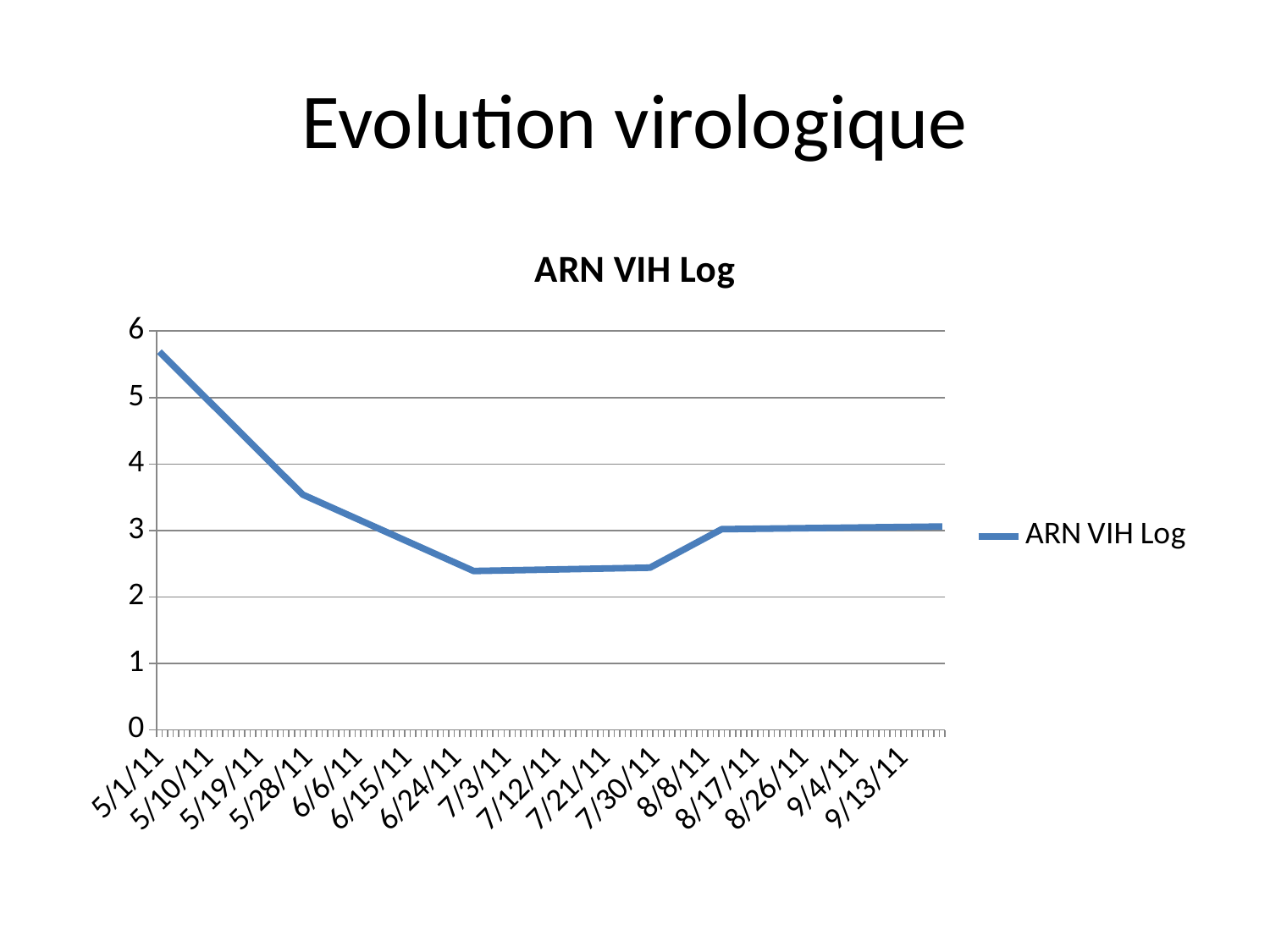
What is the name of the series shown in the legend? ARN VIH Log Is the value for 7/21/11 greater or less than 3? less Does the ARN VIH Log value rise or fall between 5/1/11 and 6/24/11? fall Which is larger, the value for 5/28/11 or the value for 6/24/11? 5/28/11 Which is larger, the value for 5/1/11 or the value for 9/13/11? 5/1/11 On which date is the ARN VIH Log value highest? 5/1/11 What kind of chart is shown on the slide? line chart How many series does the legend list? 1 Is the value for 5/1/11 greater or less than 5? greater What is the title of the chart? ARN VIH Log Is the value for 5/28/11 greater or less than 3? greater